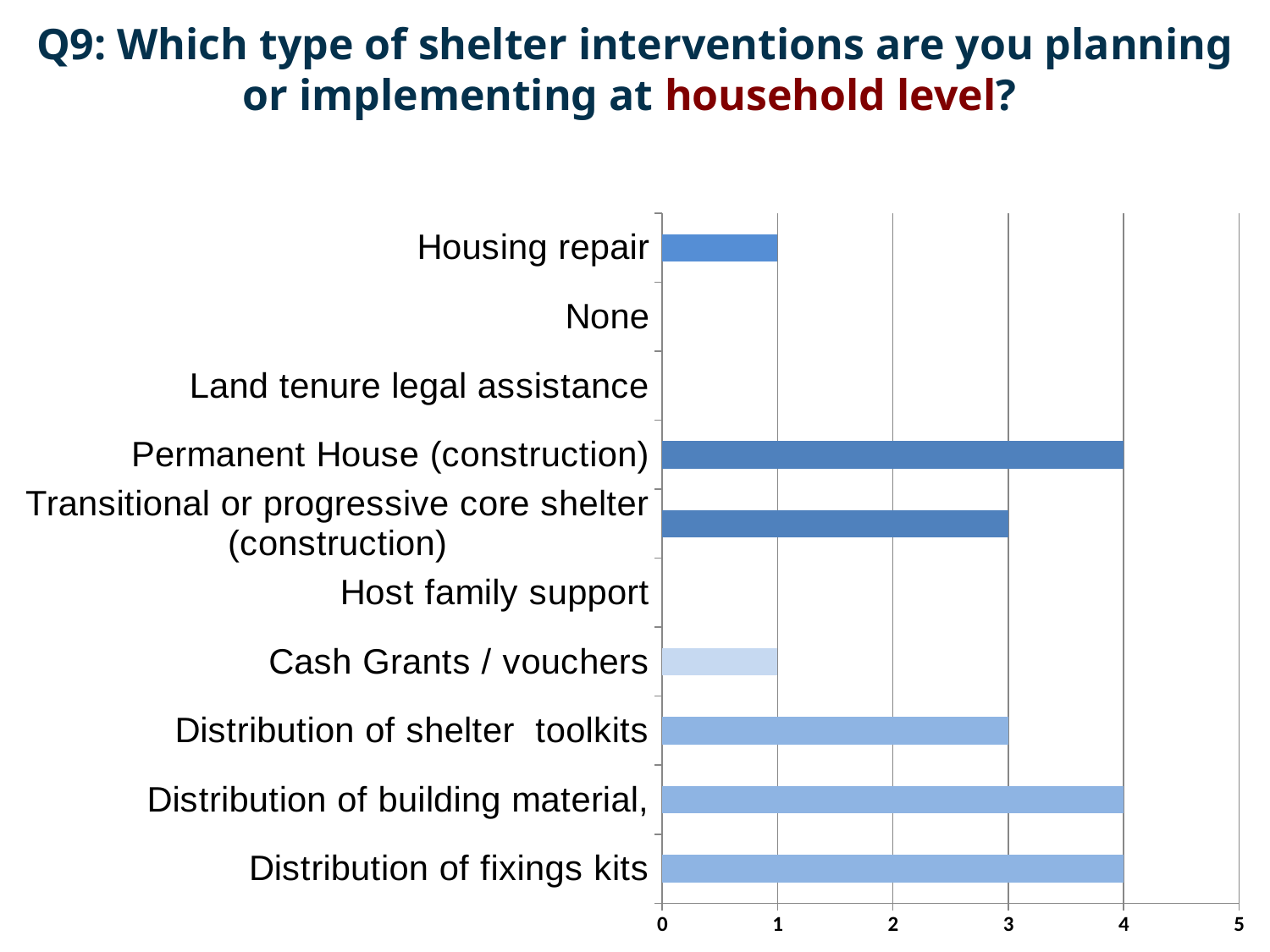
What is the value for Distribution of fixings kits? 4 What is the value for Cash Grants / vouchers? 1 What type of chart is shown on the slide? bar chart How many categories are shown on the chart? 10 What is the maximum value shown on the horizontal axis? 5 What is the difference between the values for Permanent House (construction) and Housing repair? 3 What is the value for Transitional or progressive core shelter (construction)? 3 Which is larger, the value for Distribution of building material or the value for Distribution of shelter toolkits? Distribution of building material What is the value for Permanent House (construction)? 4 Is the value for Transitional or progressive core shelter (construction) greater or less than 2? greater What is the value for Distribution of shelter toolkits? 3 What is the value for Housing repair? 1